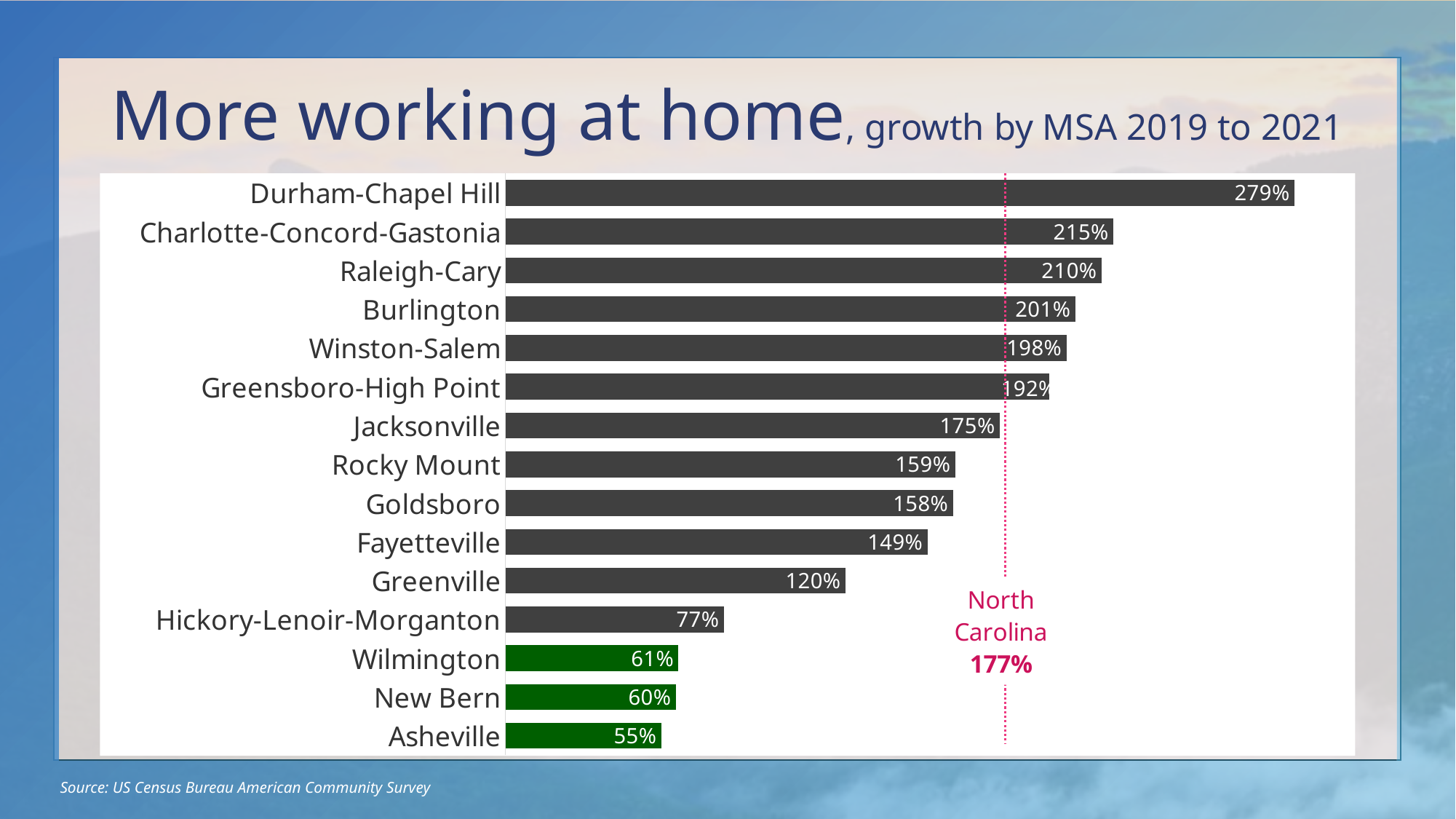
What is the growth value shown for Asheville? 55% What is the difference between the values for Durham-Chapel Hill and Asheville? 224% How many MSAs are shown in the chart? 15 What kind of chart is shown on the slide? Bar chart What is the growth value shown for Durham-Chapel Hill? 279% How many bars are coloured green? 3 Which MSA has the highest growth in working at home? Durham-Chapel Hill What is the difference between the values for Charlotte-Concord-Gastonia and Raleigh-Cary? 5% Which has a larger value, Jacksonville or Hickory-Lenoir-Morganton? Jacksonville Which MSA has the lowest growth in working at home? Asheville What is the growth value shown for Greenville? 120% What growth value is shown for North Carolina as a whole by the dotted line? 177%